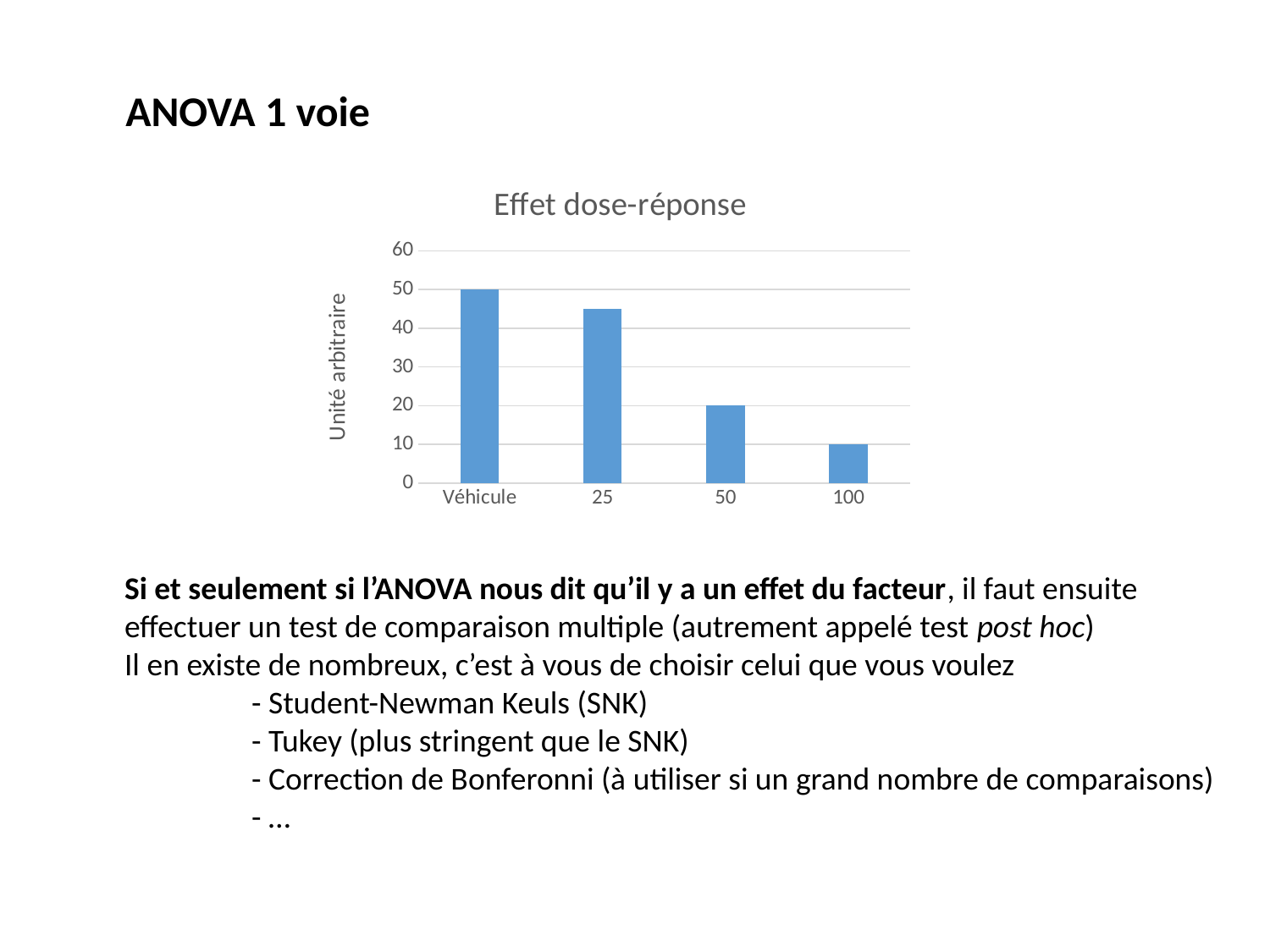
Which category has the highest bar in the Effet dose-réponse chart? Véhicule What is the difference between the values for Véhicule and the 100 dose? 40 Do the values rise or fall from Véhicule to the 100 dose along the x axis? fall How many categories are shown on the x axis of the chart? 4 What is the value for the 100 dose in the Effet dose-réponse chart? 10 What is the value for Véhicule in the Effet dose-réponse chart? 50 What is the difference between the values for Véhicule and the 50 dose? 30 Which has the larger value, the 25 dose or the 50 dose? 25 What is the value for the 50 dose in the Effet dose-réponse chart? 20 What kind of chart is shown on the slide? bar chart Is the value for the 25 dose greater or less than 40? greater Which category has the lowest bar in the Effet dose-réponse chart? 100